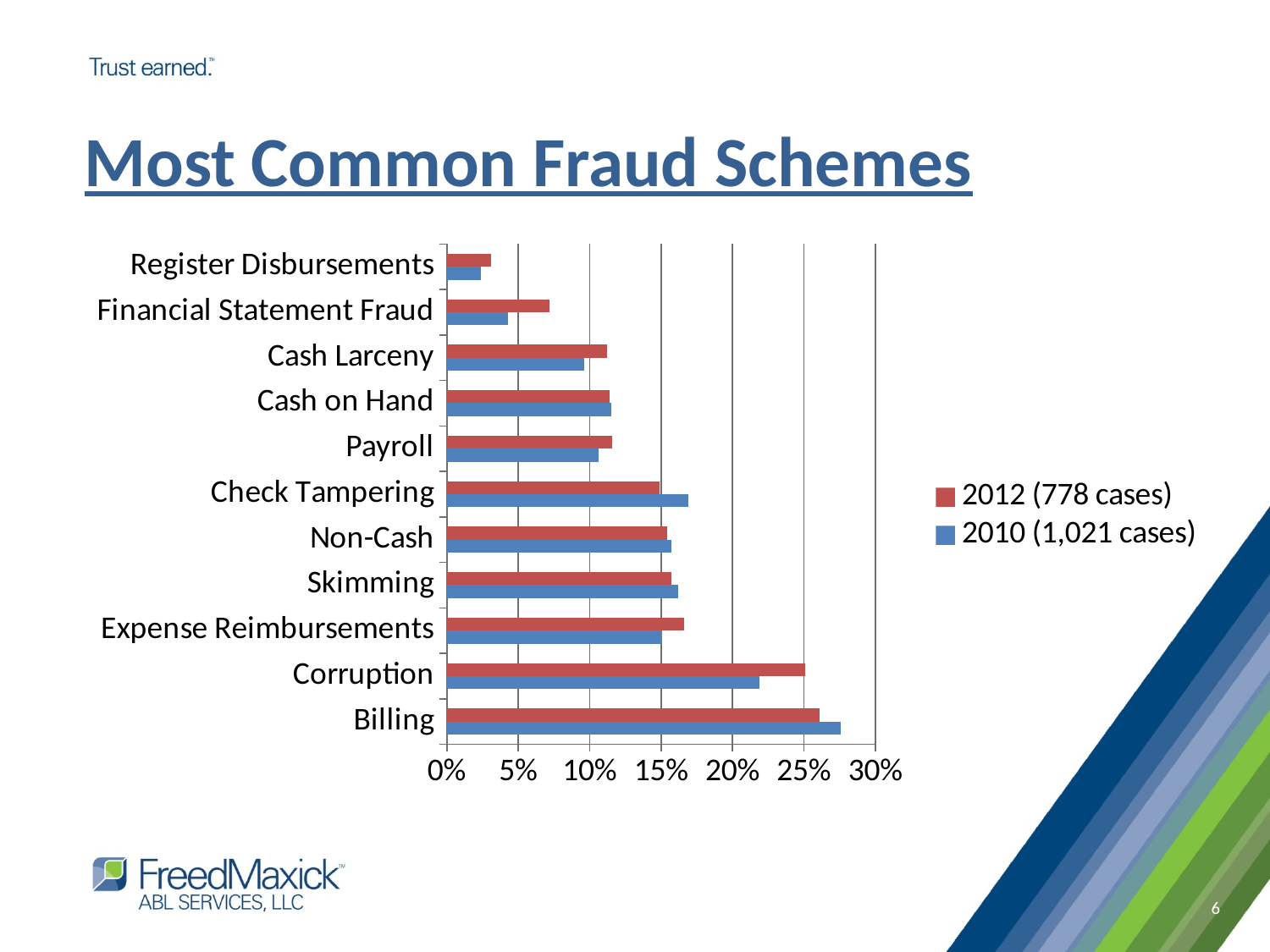
Is the 2012 (778 cases) value for Financial Statement Fraud greater or less than 10%? less What are the two series named in the legend? 2012 (778 cases) and 2010 (1,021 cases) Which category has the highest value for the 2010 (1,021 cases) series? Billing Is the 2012 (778 cases) value for Corruption greater or less than 20%? greater Which category has the lowest value for the 2012 (778 cases) series? Register Disbursements How many series does the legend list? 2 For Corruption, which series has the larger value, 2012 (778 cases) or 2010 (1,021 cases)? 2012 (778 cases) Is the 2010 (1,021 cases) value for Billing greater or less than 25%? greater Which category has the lowest value for the 2010 (1,021 cases) series? Register Disbursements For Check Tampering, which series has the larger value, 2012 (778 cases) or 2010 (1,021 cases)? 2010 (1,021 cases) What kind of chart is shown on the slide? bar chart How many fraud scheme categories are plotted on the chart? 11